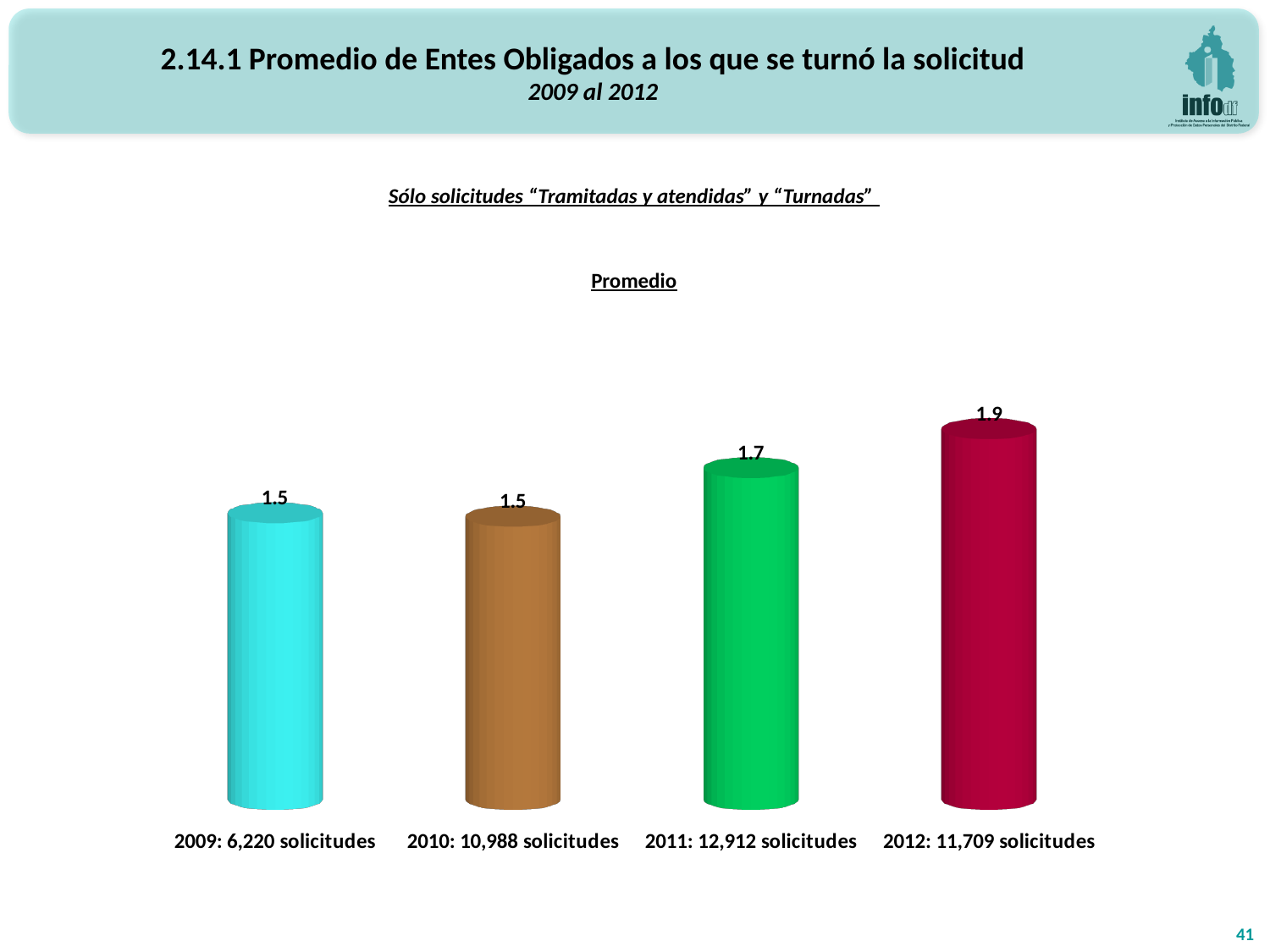
Which is larger, the average value for 2011 or for 2010? 2011 Do the average values rise or fall from 2009 to 2012? Rise What is the average value shown for 2012? 1.9 What is the difference between the average values for 2011 and 2010? 0.2 How many solicitudes are indicated in the category label for 2011? 12,912 How many bars are shown in the chart? 4 What is the average (Promedio) value shown for 2009? 1.5 What is the title shown above the chart? Promedio What is the average value shown for 2011? 1.7 What is the difference between the average values for 2012 and 2009? 0.4 What kind of chart is shown on the slide? Bar chart Which year has the highest average value? 2012